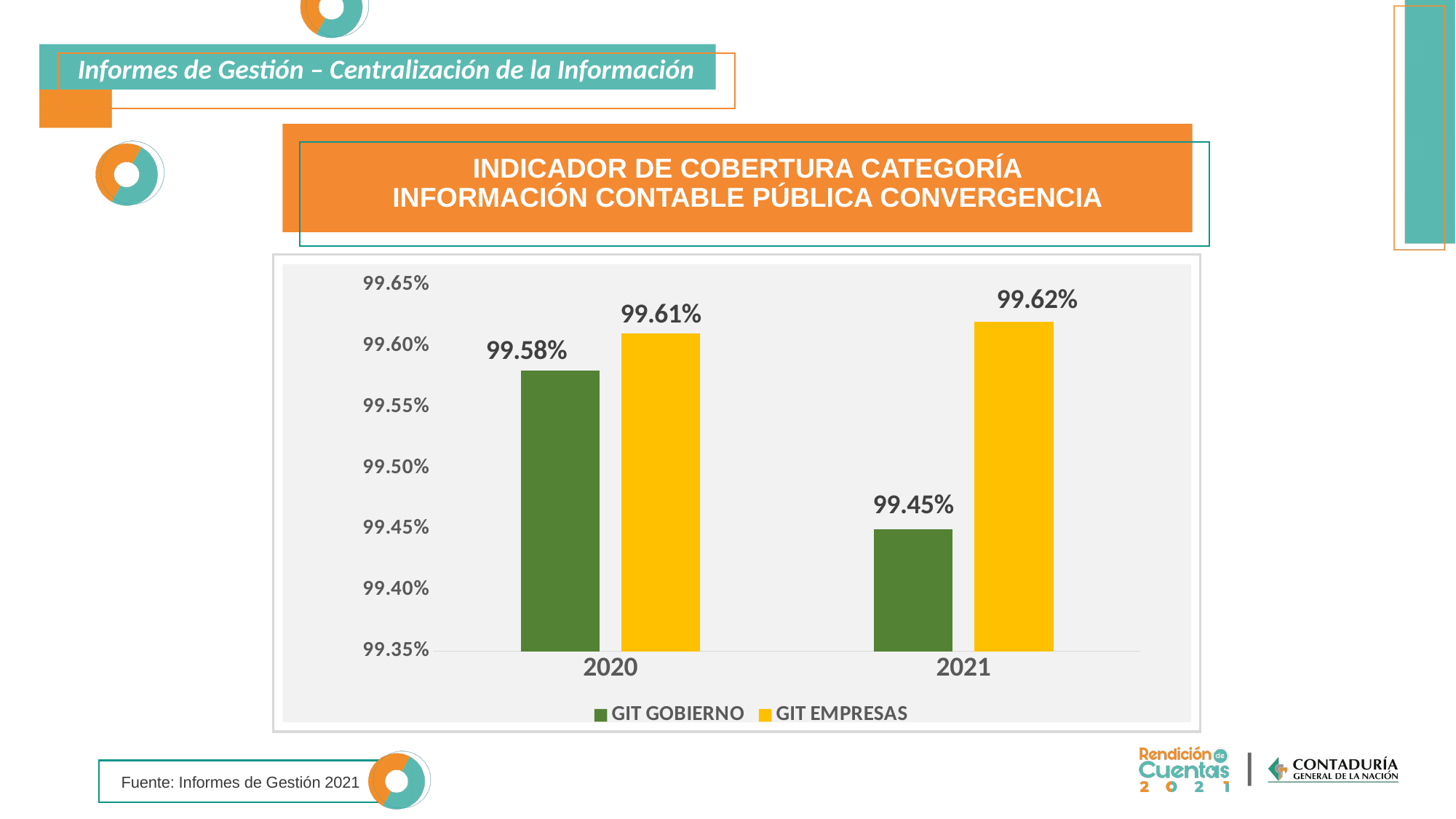
What is the value for GIT GOBIERNO in 2021? 99.45% Which is larger in 2020, GIT GOBIERNO or GIT EMPRESAS? GIT EMPRESAS What is the difference between GIT EMPRESAS and GIT GOBIERNO in 2021? 0.17% Which bar has the lowest value on the chart? GIT GOBIERNO in 2021 Does the value for GIT GOBIERNO rise or fall from 2020 to 2021? fall Which bar has the highest value on the chart? GIT EMPRESAS in 2021 What kind of chart is shown on the slide? bar chart What is the value for GIT EMPRESAS in 2021? 99.62% What is the value for GIT GOBIERNO in 2020? 99.58% What is the value for GIT EMPRESAS in 2020? 99.61% How many years are shown on the x axis? 2 How many series does the legend list? 2